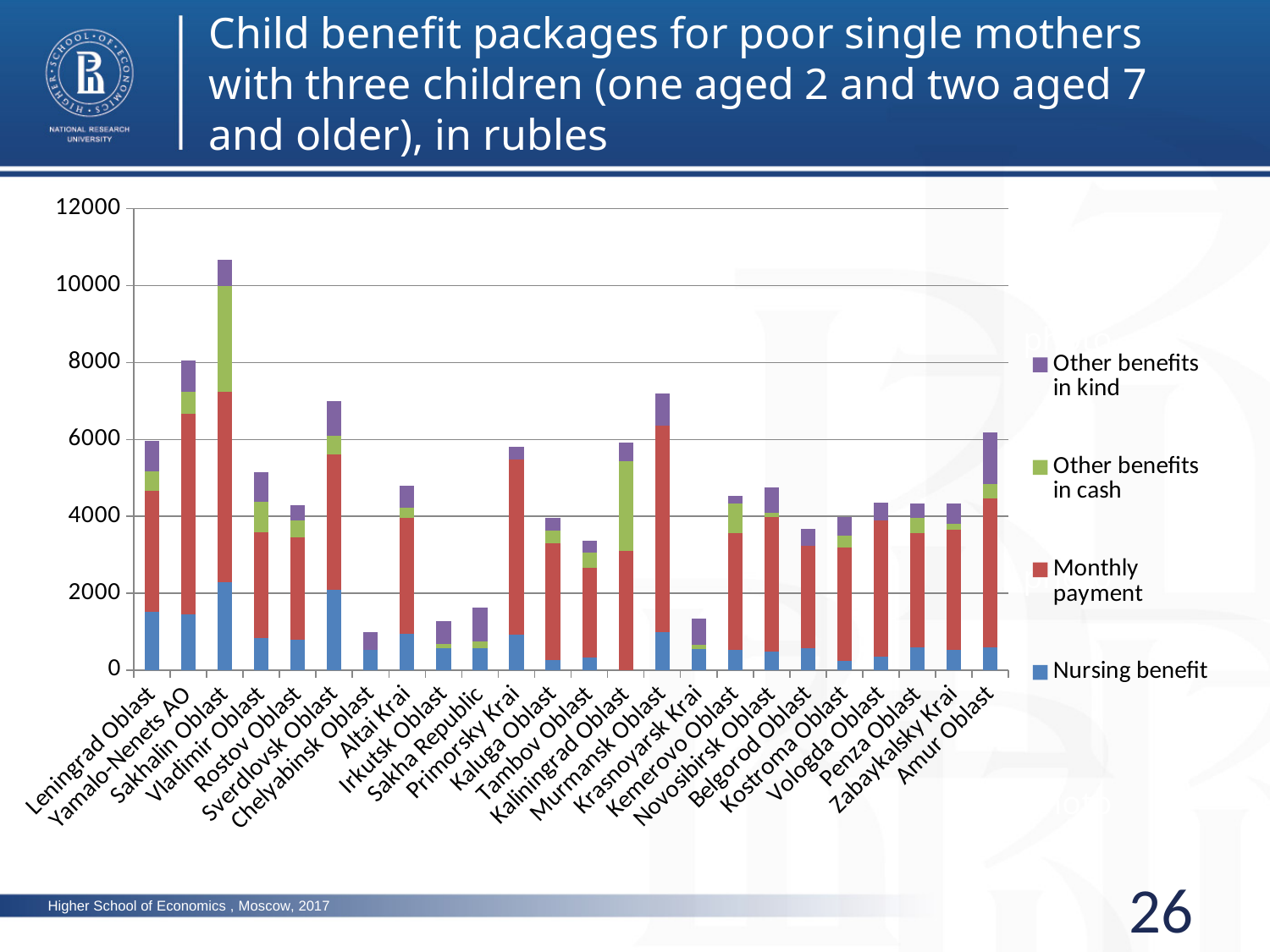
How many regions are shown on the x axis of the chart? 24 Is the total value for Murmansk Oblast greater or less than 6000? greater Is the total value for Chelyabinsk Oblast greater or less than 2000? less Which region has the lowest total child benefit package? Chelyabinsk Oblast Which series in the legend is shown in red? Monthly payment Is the total value for Sakhalin Oblast greater or less than 10000? greater Which has the larger total benefit package, Murmansk Oblast or Kaliningrad Oblast? Murmansk Oblast Which region has the highest total child benefit package? Sakhalin Oblast How many series does the chart's legend list? 4 What kind of chart is shown on the slide? Stacked bar chart Which has the larger total benefit package, Leningrad Oblast or Vladimir Oblast? Leningrad Oblast